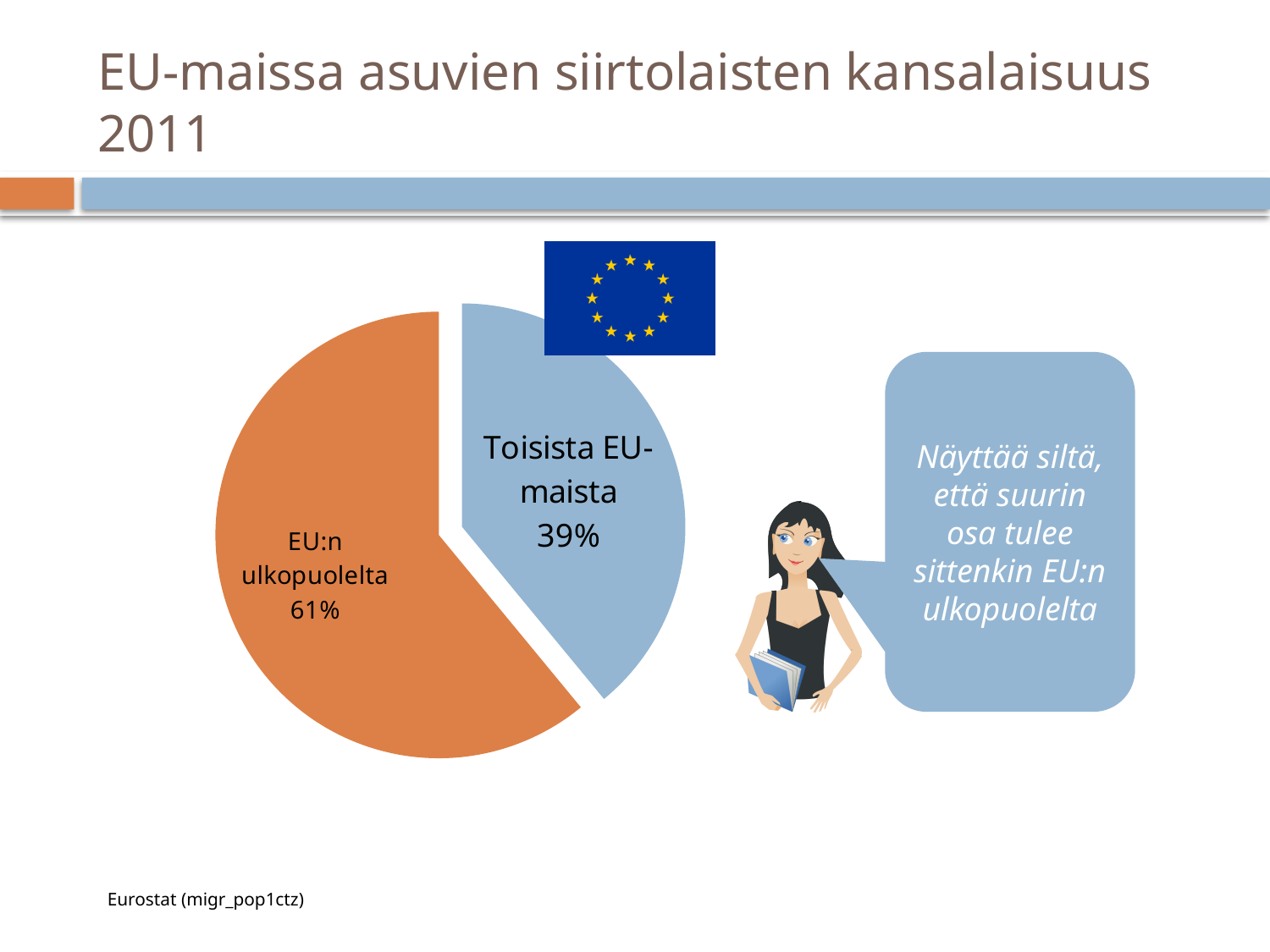
Is the share for "Toisista EU-maista" greater or less than 50%? less Which slice of the pie is the smallest? Toisista EU-maista How many slices does the pie chart have? 2 What is the title of the slide containing the pie chart? EU-maissa asuvien siirtolaisten kansalaisuus 2011 What share of the pie does "EU:n ulkopuolelta" represent? 61% What kind of chart is shown on the slide? pie chart Which is larger: the share for "EU:n ulkopuolelta" or the share for "Toisista EU-maista"? EU:n ulkopuolelta Which slice of the pie is the largest? EU:n ulkopuolelta What colour is the "EU:n ulkopuolelta" slice? orange What is the difference in percentage points between the "EU:n ulkopuolelta" and "Toisista EU-maista" slices? 22 What share of the pie does "Toisista EU-maista" represent? 39%